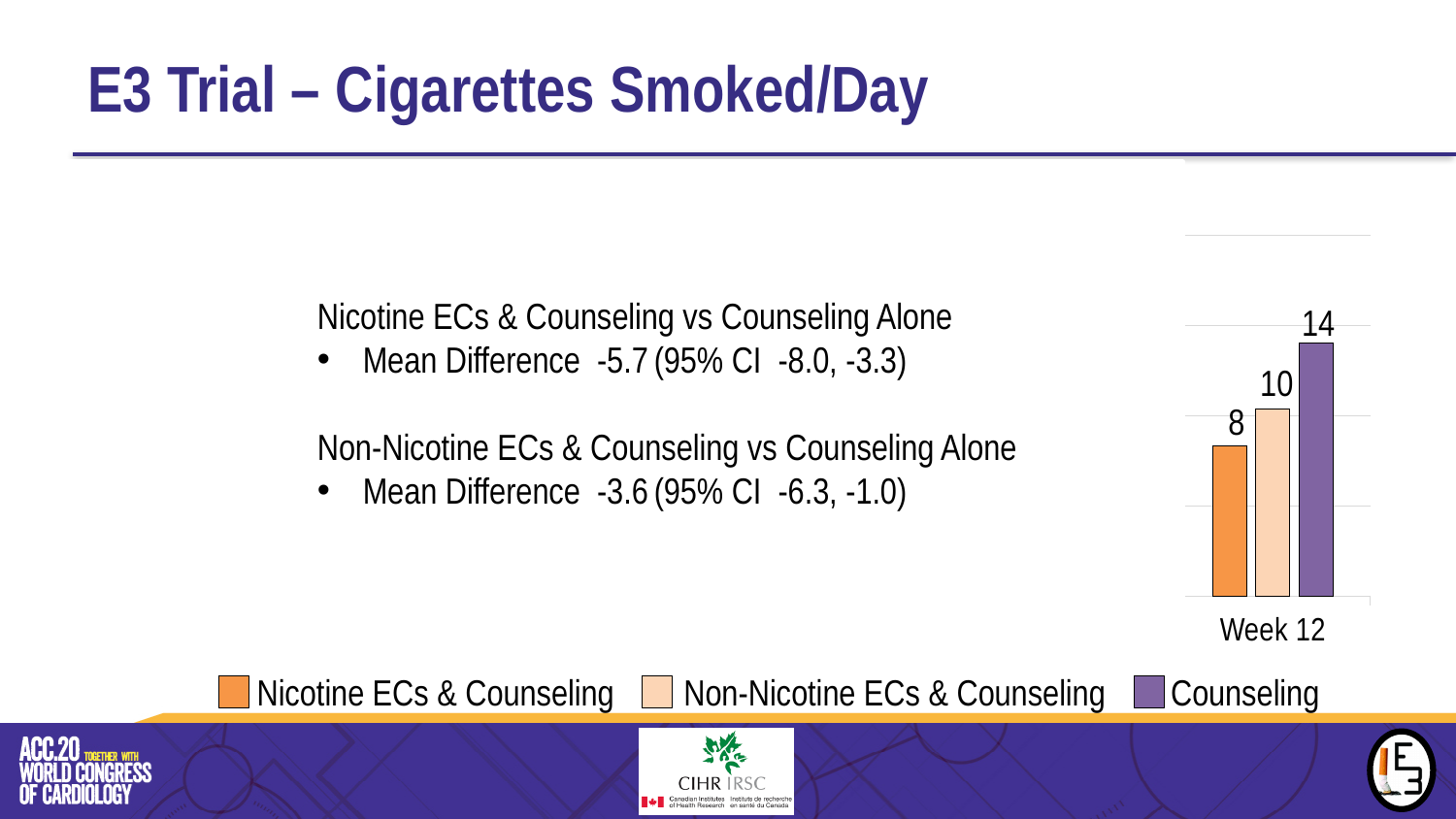
How many series does the legend list? 3 What is the value for Nicotine ECs & Counseling at Week 12? 8 How many categories are shown on the x axis of the chart? 1 What is the value for Counseling at Week 12? 14 Which series has the highest value at Week 12? Counseling What colour is the bar for Counseling? Purple What kind of chart is shown on the slide? Bar chart What is the value for Non-Nicotine ECs & Counseling at Week 12? 10 What is the difference between the Non-Nicotine ECs & Counseling value and the Nicotine ECs & Counseling value at Week 12? 2 Which is larger at Week 12: Non-Nicotine ECs & Counseling or Counseling? Counseling What is the difference between the Counseling value and the Nicotine ECs & Counseling value at Week 12? 6 Which series has the lowest value at Week 12? Nicotine ECs & Counseling